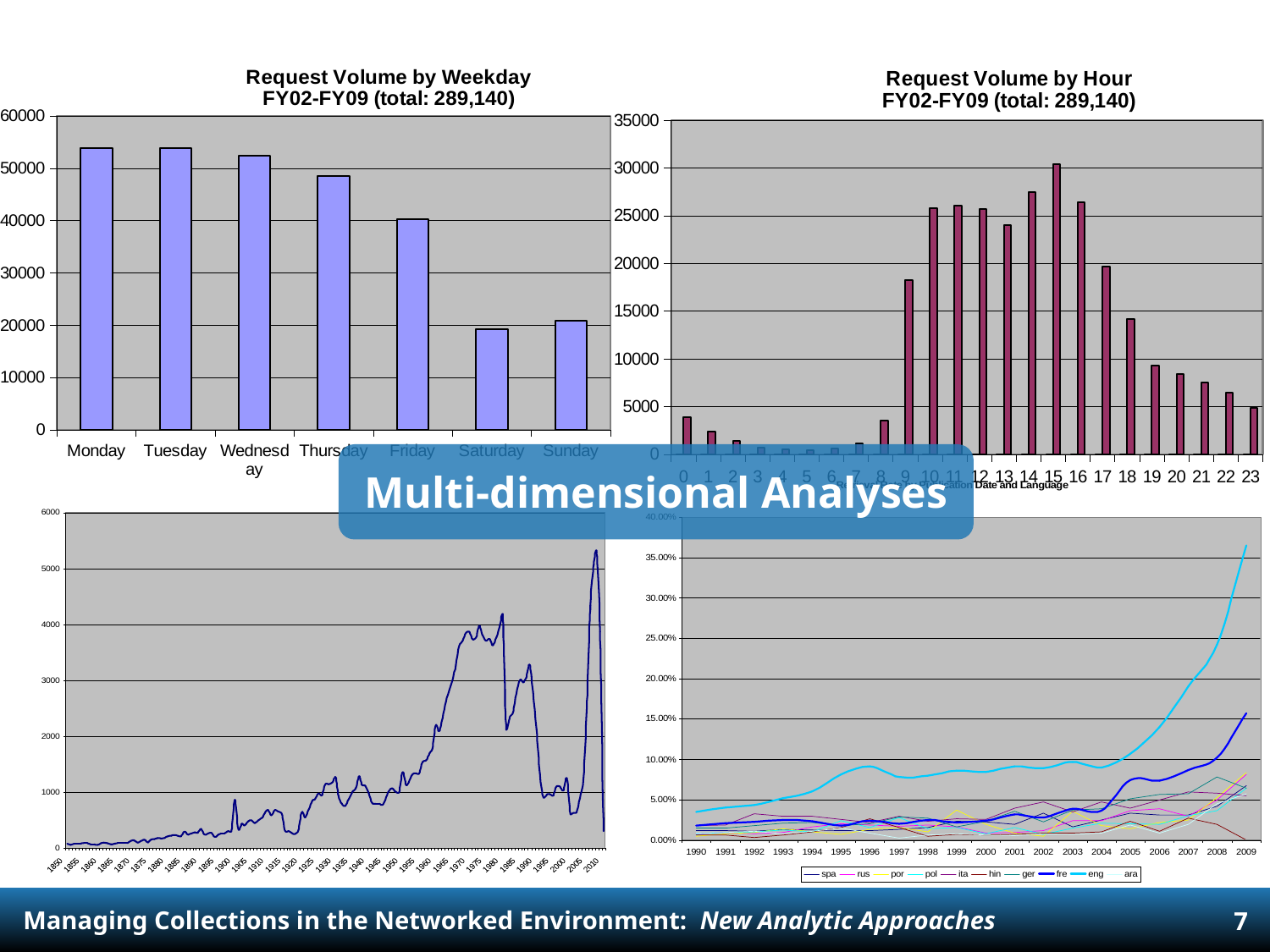
In the 'Request Volume by Weekday' chart, is the value for Monday greater or less than 50000? greater In the 'Request Volume by Hour' chart, which is larger, the value for hour 9 or the value for hour 10? hour 10 In the 'Request Volume by Hour' chart, is the value for hour 9 greater or less than 15000? greater In the 'Request Volume by Weekday' chart, how many weekdays are plotted? 7 In the 'Request Volume by Weekday' chart, is the value for Friday greater or less than 50000? less What kind of chart is 'Request Volume by Weekday'? bar chart In the 'Request Volume by Hour' chart, which hour has the highest request volume? 15 In the bottom-right line chart, how many series does the legend list? 10 In the bottom-right line chart, which series has the highest value in 2009? eng In the 'Request Volume by Weekday' chart, which weekday has the lowest request volume? Saturday In the 'Request Volume by Hour' chart, how many hours are plotted? 24 In the 'Request Volume by Weekday' chart, which is larger, the value for Thursday or the value for Friday? Thursday